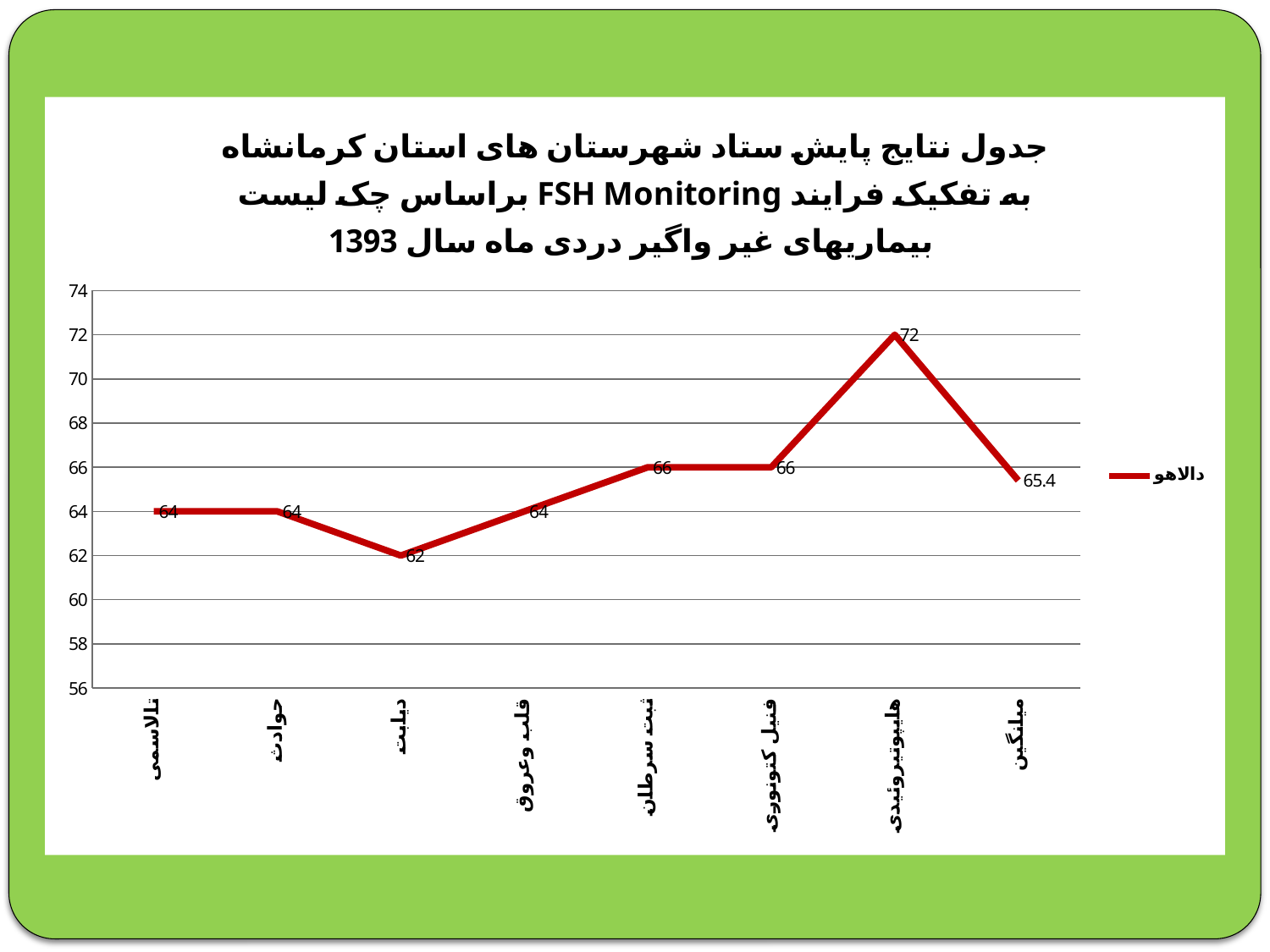
What is the difference between the values for هیپوتیروئیدی and دیابت? 10 What is the name of the series shown in the legend? دالاهو Which category has the highest value? هیپوتیروئیدی What is the value for ثبت سرطان? 66 What is the value for دیابت? 62 What is the value for هیپوتیروئیدی? 72 How many series does the legend list? 1 How many categories are plotted on the x axis? 8 What type of chart is shown on the slide? line chart What is the value for میانگین? 65.4 Which is larger, the value for فنیل کتونوری or the value for قلب وعروق? فنیل کتونوری Which category has the lowest value? دیابت